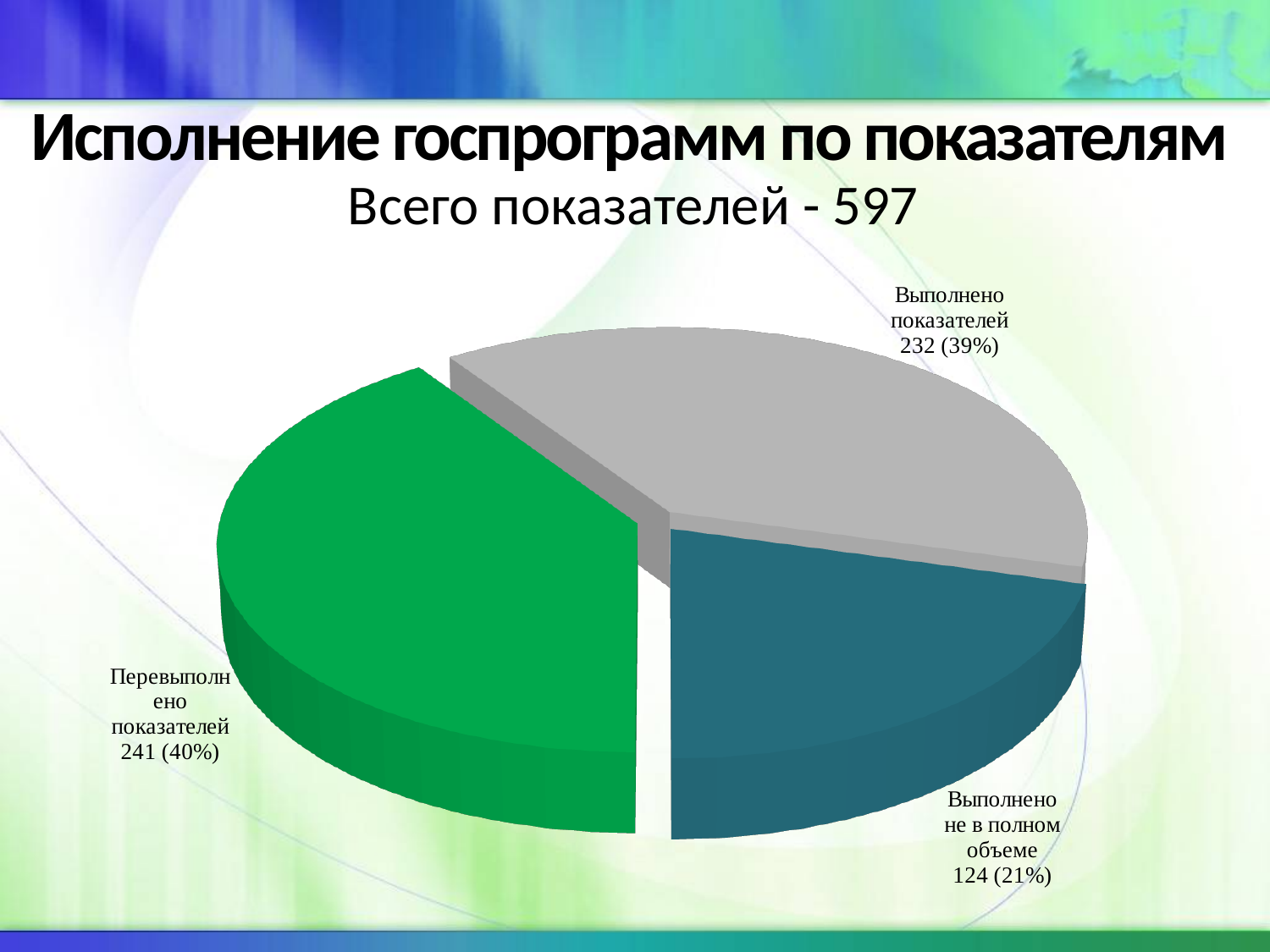
How many indicators were not fully fulfilled (Выполнено не в полном объеме)? 124 How many indicators were overfulfilled (Перевыполнено показателей)? 241 Which category has the smallest slice? Выполнено не в полном объеме What share of the pie is 'Перевыполнено показателей'? 40% What share of the pie is 'Выполнено не в полном объеме'? 21% What is the difference between the number of fulfilled indicators (232) and not fully fulfilled indicators (124)? 108 How many slices does the pie chart have? 3 What is the total number of indicators stated on the slide? 597 How many indicators were fulfilled (Выполнено показателей)? 232 What colour is the 'Перевыполнено показателей' slice? green Which is larger: 'Перевыполнено показателей' or 'Выполнено не в полном объеме'? Перевыполнено показателей What kind of chart is shown on the slide? pie chart